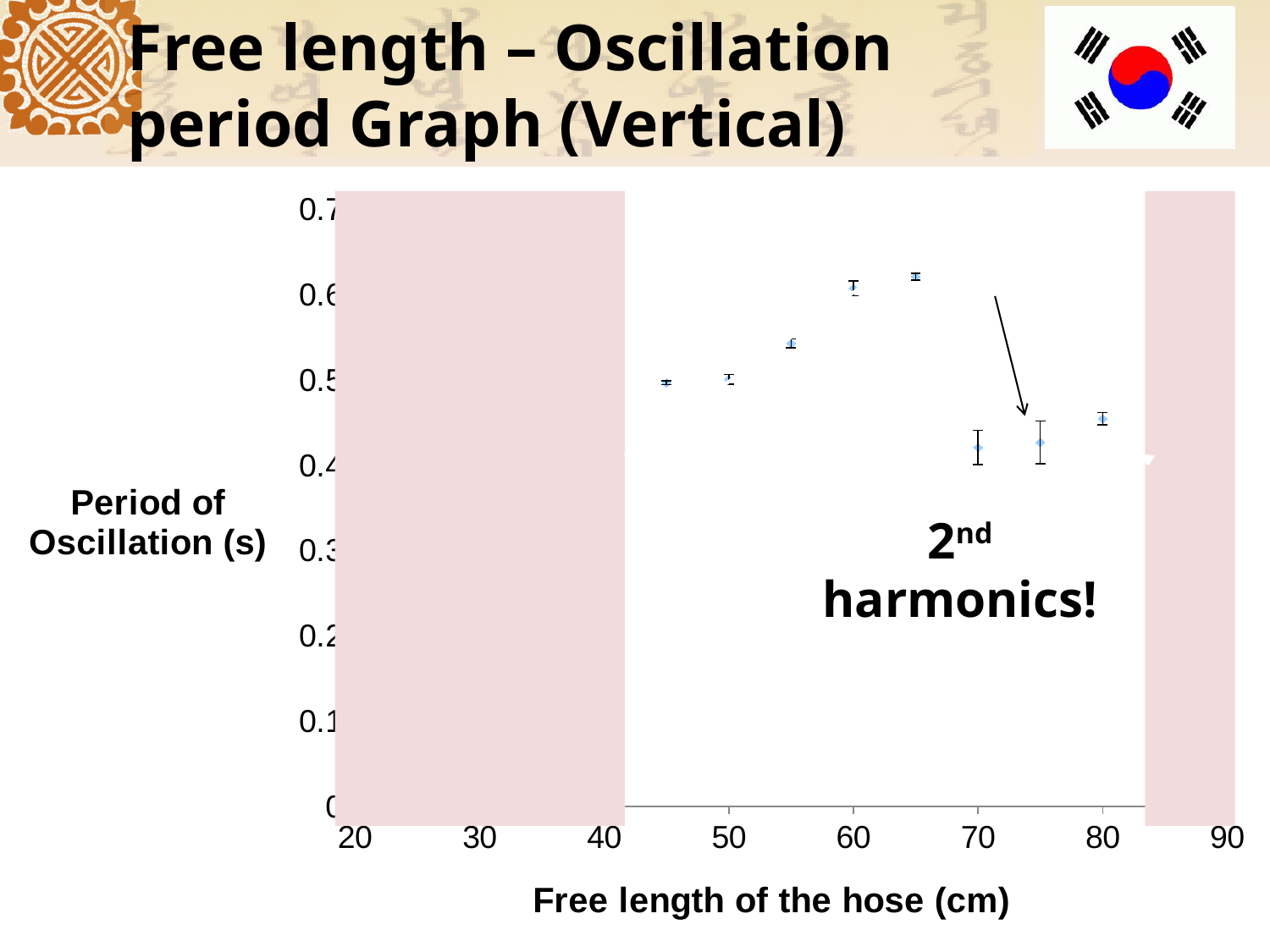
Is the period of oscillation at a free length of 70 cm greater or less than 0.5 s? less What is the label of the x axis? Free length of the hose (cm) Is the period of oscillation at a free length of 65 cm greater or less than 0.5 s? greater How many data points are visible on the chart? 8 Is the period of oscillation at a free length of 75 cm greater or less than 0.4 s? greater Does the period of oscillation rise or fall as the free length increases from 45 cm to 65 cm? rise What kind of chart is shown on the slide? scatter chart What is the label of the y axis? Period of Oscillation (s) Which has the larger period of oscillation: a free length of 60 cm or 70 cm? 60 cm Which has the larger period of oscillation: a free length of 65 cm or 80 cm? 65 cm